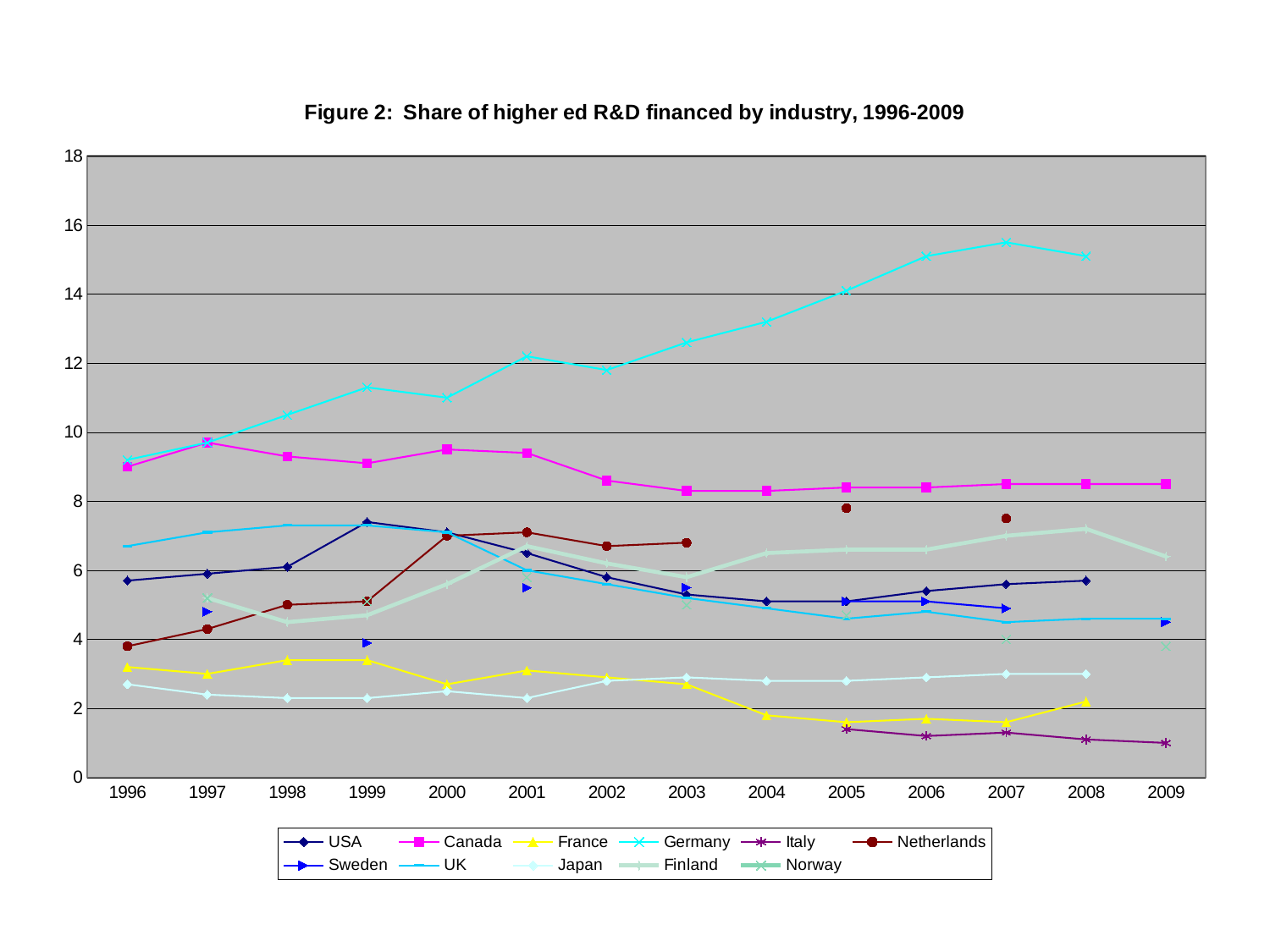
Which is larger in 2003, the value for Canada or the value for Germany? Germany What is the title of the chart? Figure 2: Share of higher ed R&D financed by industry, 1996-2009 Does the value for Germany generally rise or fall from 1996 to 2007? rise Is the value for Netherlands in 2005 greater or less than 6? greater How many series does the legend list? 11 Is the value for France in 2005 greater or less than 2? less Which country has the highest value in 2007? Germany Is the value for Germany in 2007 greater or less than 14? greater Which country has the lowest value in 2009? Italy What kind of chart is shown on the slide? line chart How many years are shown along the x axis? 14